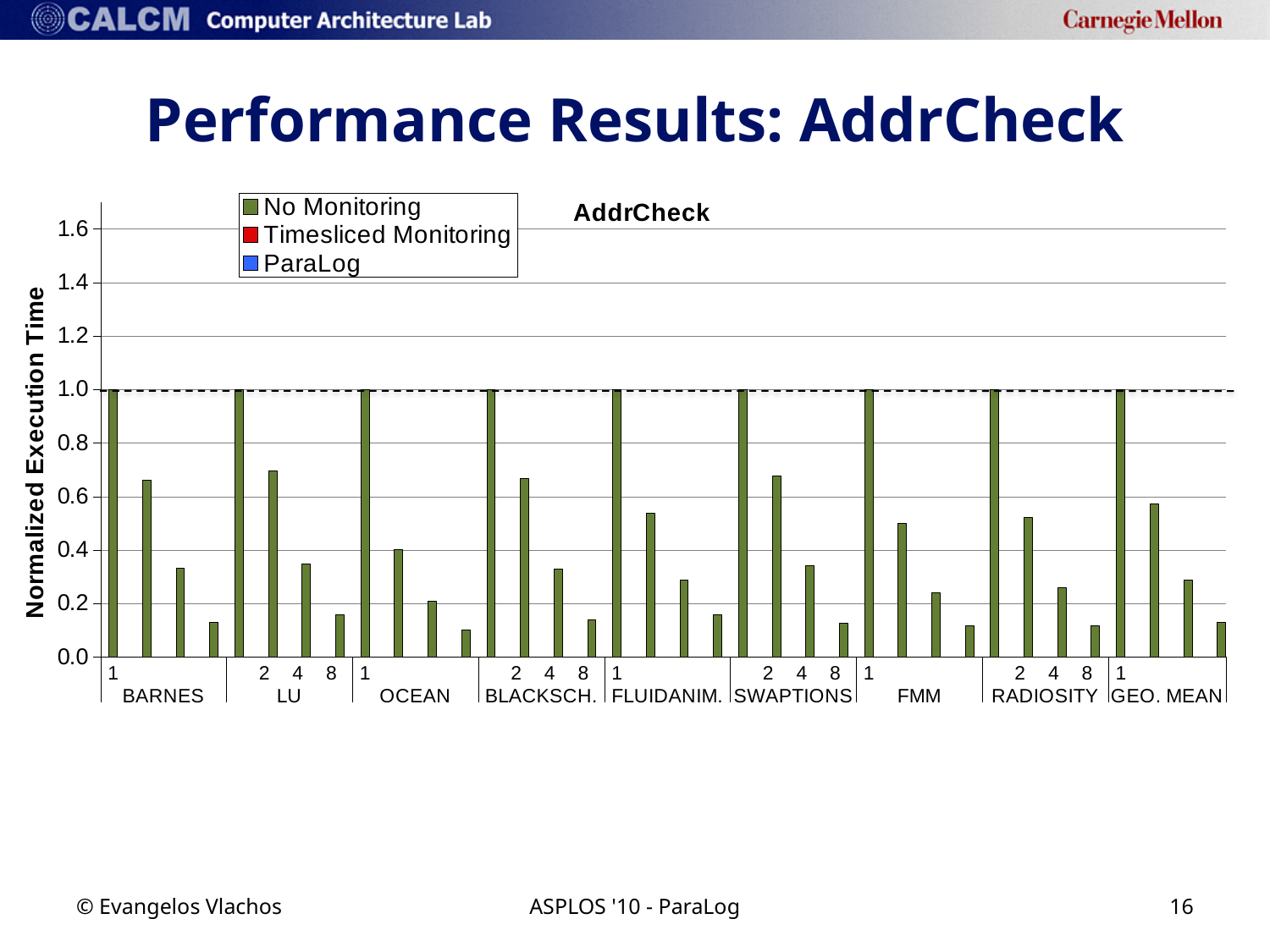
What is the label of the y axis? Normalized Execution Time Is the No Monitoring value for LU with 8 cores greater or less than 0.2? less How many series does the legend list? 3 Is the No Monitoring value for BARNES with 2 cores greater or less than 0.6? greater Is the No Monitoring value for SWAPTIONS with 2 cores greater or less than 0.6? greater Within the BARNES group, do the No Monitoring values rise or fall as the core count increases from 1 to 8? fall Within the LU group, which core count has the lowest No Monitoring value? 8 What kind of chart is shown on the slide? bar chart What is the No Monitoring value for BARNES with 1 core? 1.0 Which is larger, the No Monitoring value for LU with 2 cores or for OCEAN with 2 cores? LU with 2 cores How many benchmark groups are shown along the x axis? 9 What is the title printed inside the chart area? AddrCheck